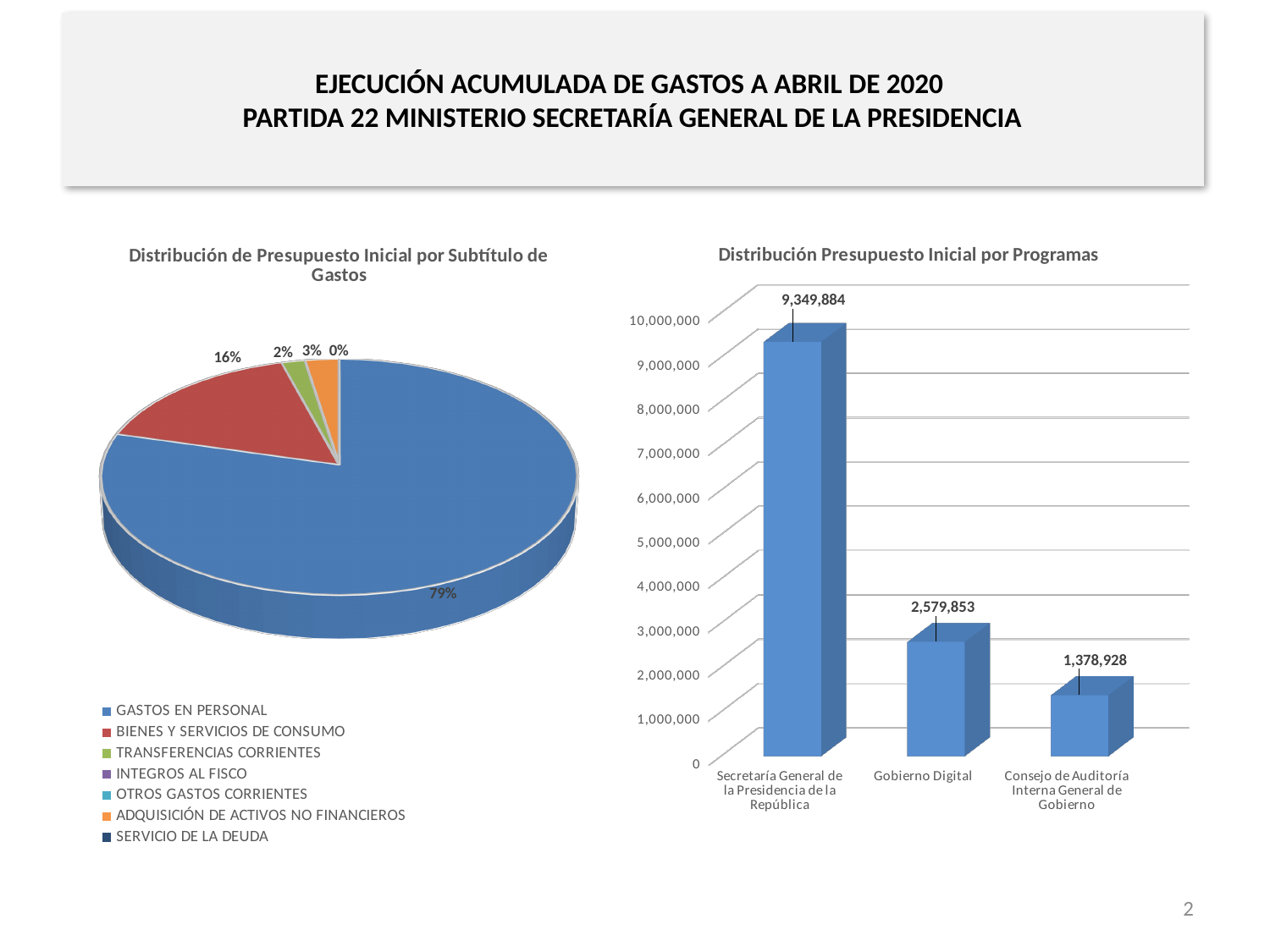
In the pie chart 'Distribución de Presupuesto Inicial por Subtítulo de Gastos', what share does BIENES Y SERVICIOS DE CONSUMO have? 16% In the bar chart 'Distribución Presupuesto Inicial por Programas', how many programs are shown? 3 What kind of chart is 'Distribución Presupuesto Inicial por Programas'? Bar chart In the bar chart 'Distribución Presupuesto Inicial por Programas', what is the value for Consejo de Auditoría Interna General de Gobierno? 1,378,928 In the bar chart 'Distribución Presupuesto Inicial por Programas', what is the difference between Gobierno Digital and Consejo de Auditoría Interna General de Gobierno? 1,200,925 In the bar chart 'Distribución Presupuesto Inicial por Programas', which program has the lowest value? Consejo de Auditoría Interna General de Gobierno In the pie chart 'Distribución de Presupuesto Inicial por Subtítulo de Gastos', what share does GASTOS EN PERSONAL have? 79% In the bar chart 'Distribución Presupuesto Inicial por Programas', what is the value for Gobierno Digital? 2,579,853 How many entries does the legend of the pie chart 'Distribución de Presupuesto Inicial por Subtítulo de Gastos' list? 7 In the bar chart 'Distribución Presupuesto Inicial por Programas', which program has the highest value? Secretaría General de la Presidencia de la República In the bar chart 'Distribución Presupuesto Inicial por Programas', what is the value for Secretaría General de la Presidencia de la República? 9,349,884 In the pie chart 'Distribución de Presupuesto Inicial por Subtítulo de Gastos', which category has the largest slice? GASTOS EN PERSONAL